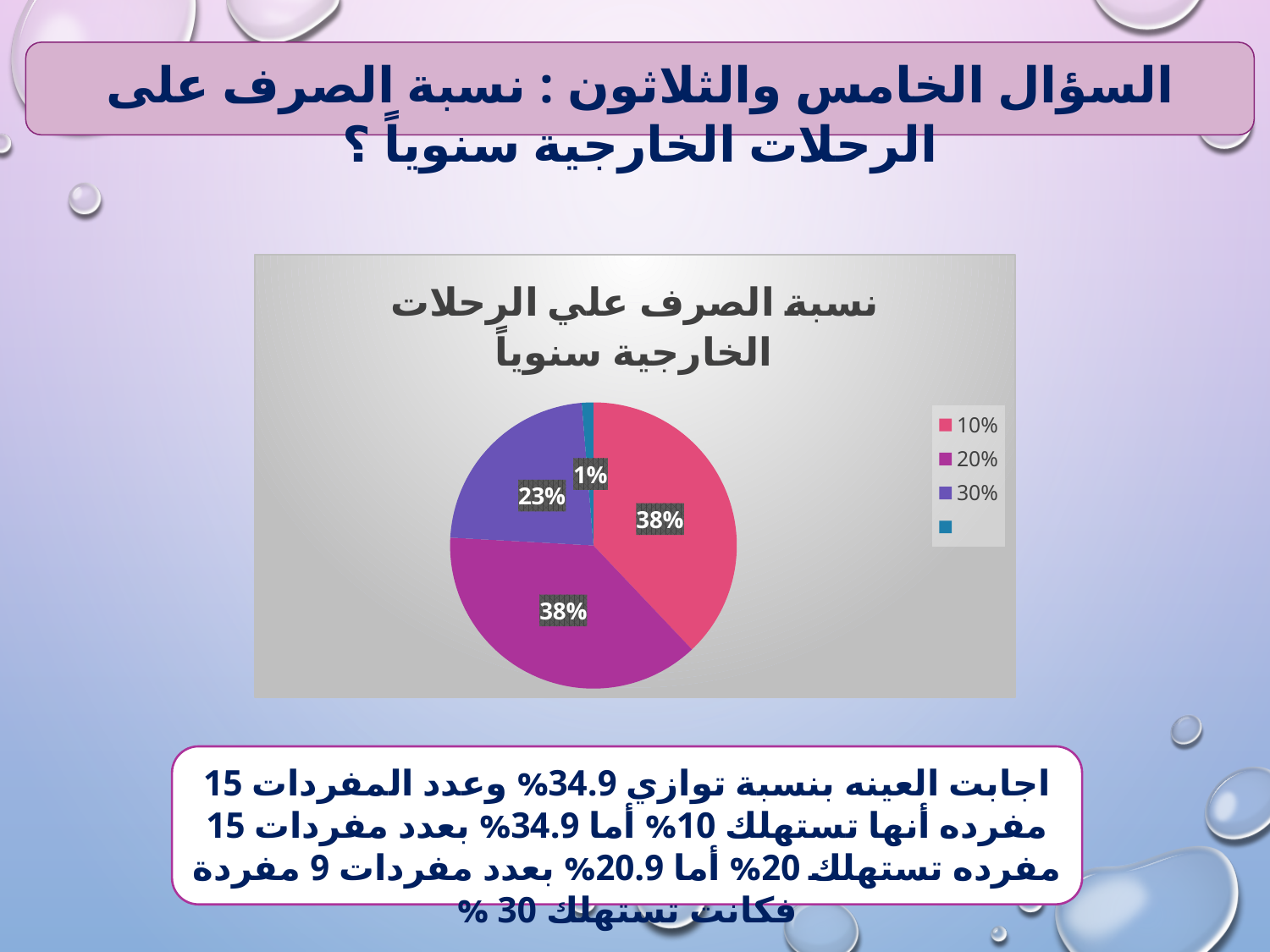
What share of the pie does the legend category "30%" have? 23% What is the title of the chart? نسبة الصرف علي الرحلات الخارجية سنوياً What share of the pie does the legend category "20%" have? 38% Is the share for the legend category "30%" greater or less than 30%? less What kind of chart is shown on the slide? pie chart What is the smallest percentage label shown on the pie? 1% What is the difference in percentage points between the share for "20%" and the share for "30%"? 15 What colour is the slice for the legend category "30%"? purple Which has the larger share of the pie, the legend category "10%" or "30%"? 10% How many slices does the pie chart have? 4 How many entries does the legend list? 4 What share of the pie does the legend category "10%" have? 38%